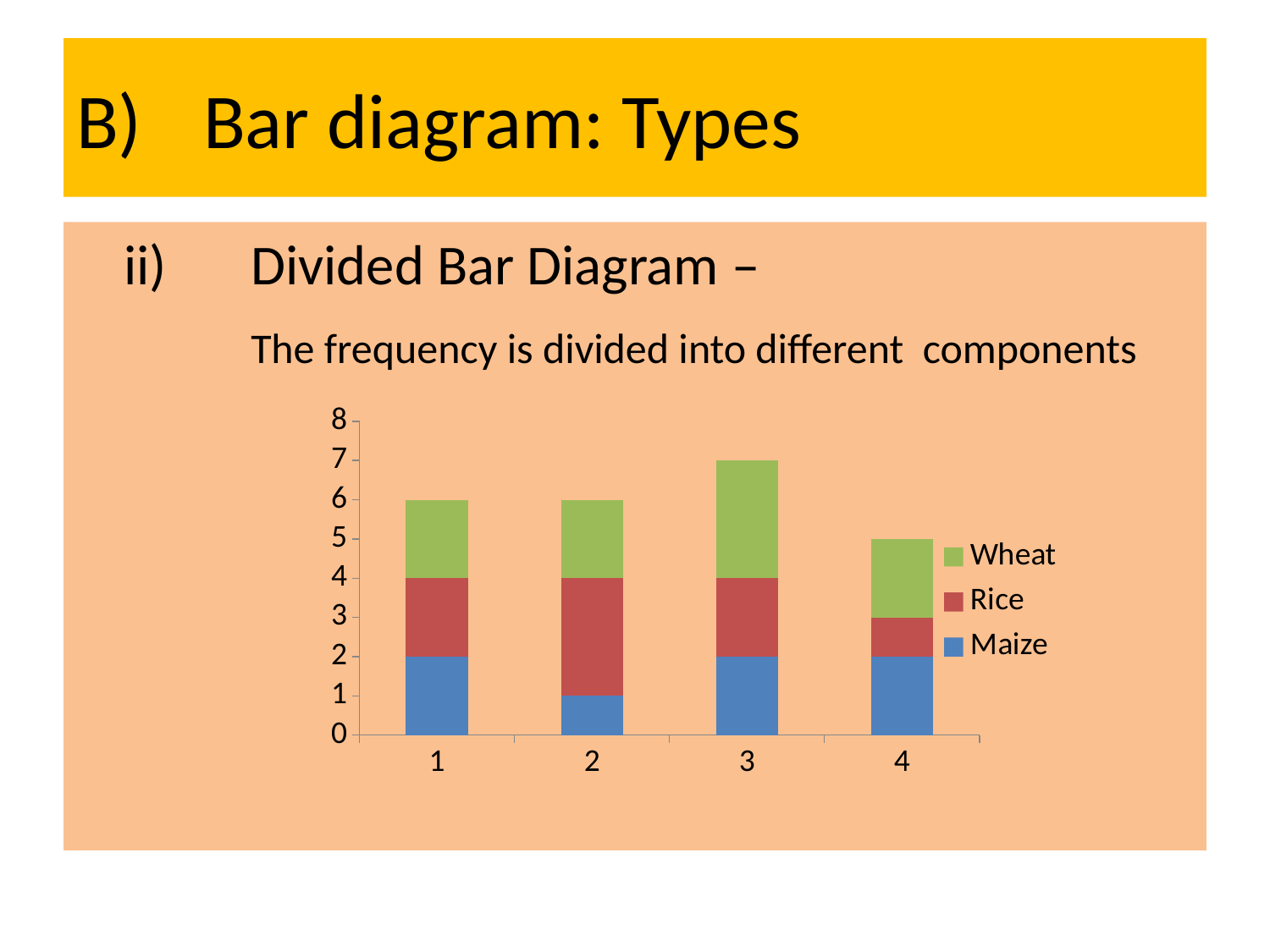
Which category has the tallest stacked bar? 3 How many series does the legend list? 3 Which is larger, the Rice value for category 2 or the Rice value for category 4? Category 2 Is the total for category 3 greater or less than 6? greater What kind of chart is shown on the slide? Stacked bar chart What is the Wheat value for category 3? 3 What is the total height of the stacked bar for category 3? 7 What is the Maize value for category 2? 1 What is the total height of the stacked bar for category 4? 5 Which series is shown in green in the legend? Wheat How many categories are shown on the x axis? 4 Which category has the shortest stacked bar? 4